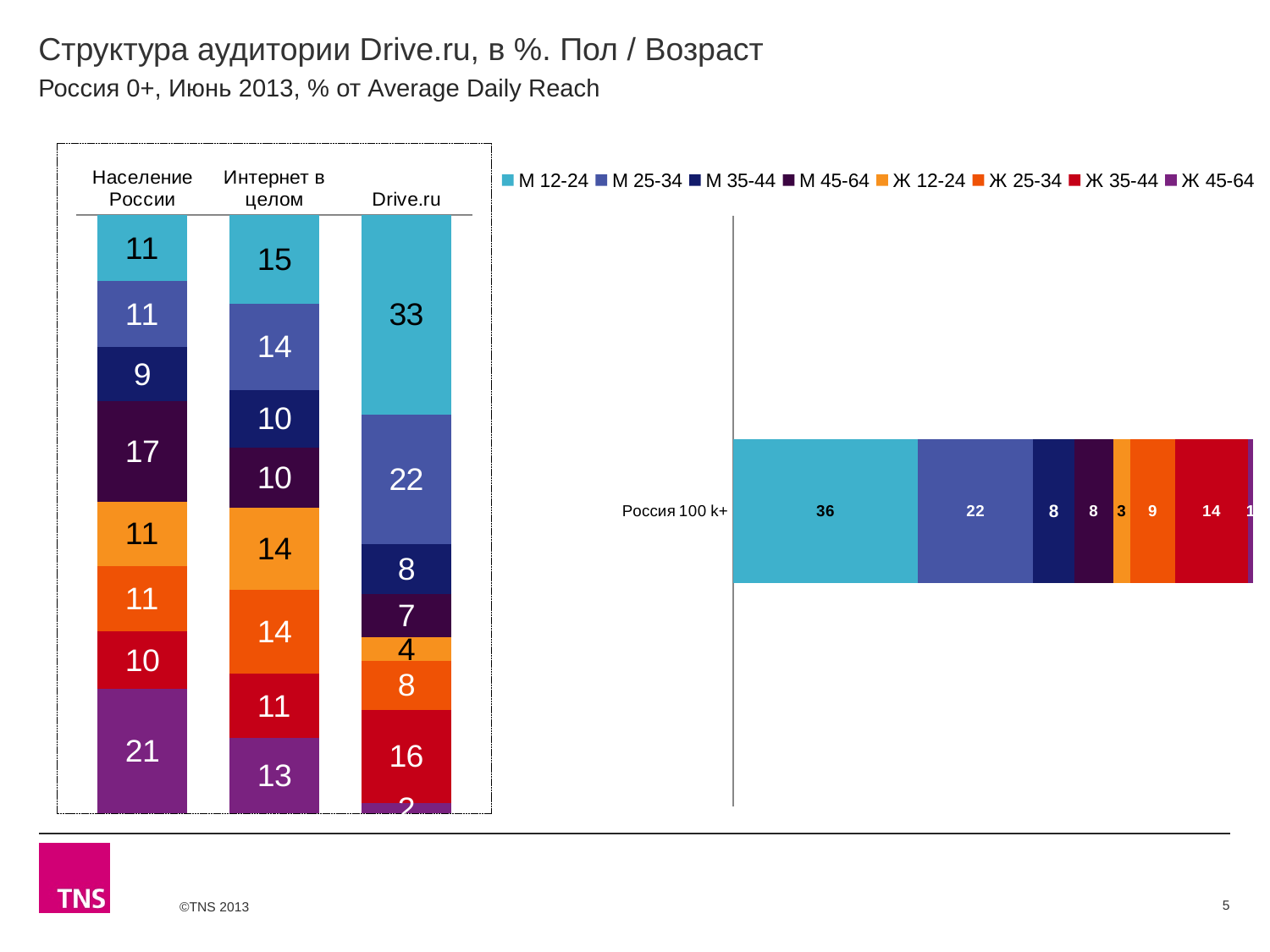
In the right chart (Россия 100 k+), what is the value of the Ж 12-24 segment? 3 In the right chart (Россия 100 k+), what is the value of the М 12-24 segment? 36 In the left chart, which segment is the largest in the Drive.ru bar? М 12-24 In the left chart, what is the value of the М 12-24 segment for Интернет в целом? 15 How many series does the legend list? 8 In the left chart, what is the value of the М 12-24 segment for Drive.ru? 33 In the left chart, which has the larger М 25-34 value: Drive.ru or Интернет в целом? Drive.ru How many bars (columns) does the left chart show? 3 In the right chart (Россия 100 k+), what is the value of the Ж 35-44 segment? 14 In the left chart, what is the difference between the М 12-24 value for Drive.ru and the М 12-24 value for Население России? 22 What kind of chart is the left chart? Stacked bar chart In the left chart, what is the value of the Ж 45-64 segment for Население России? 21